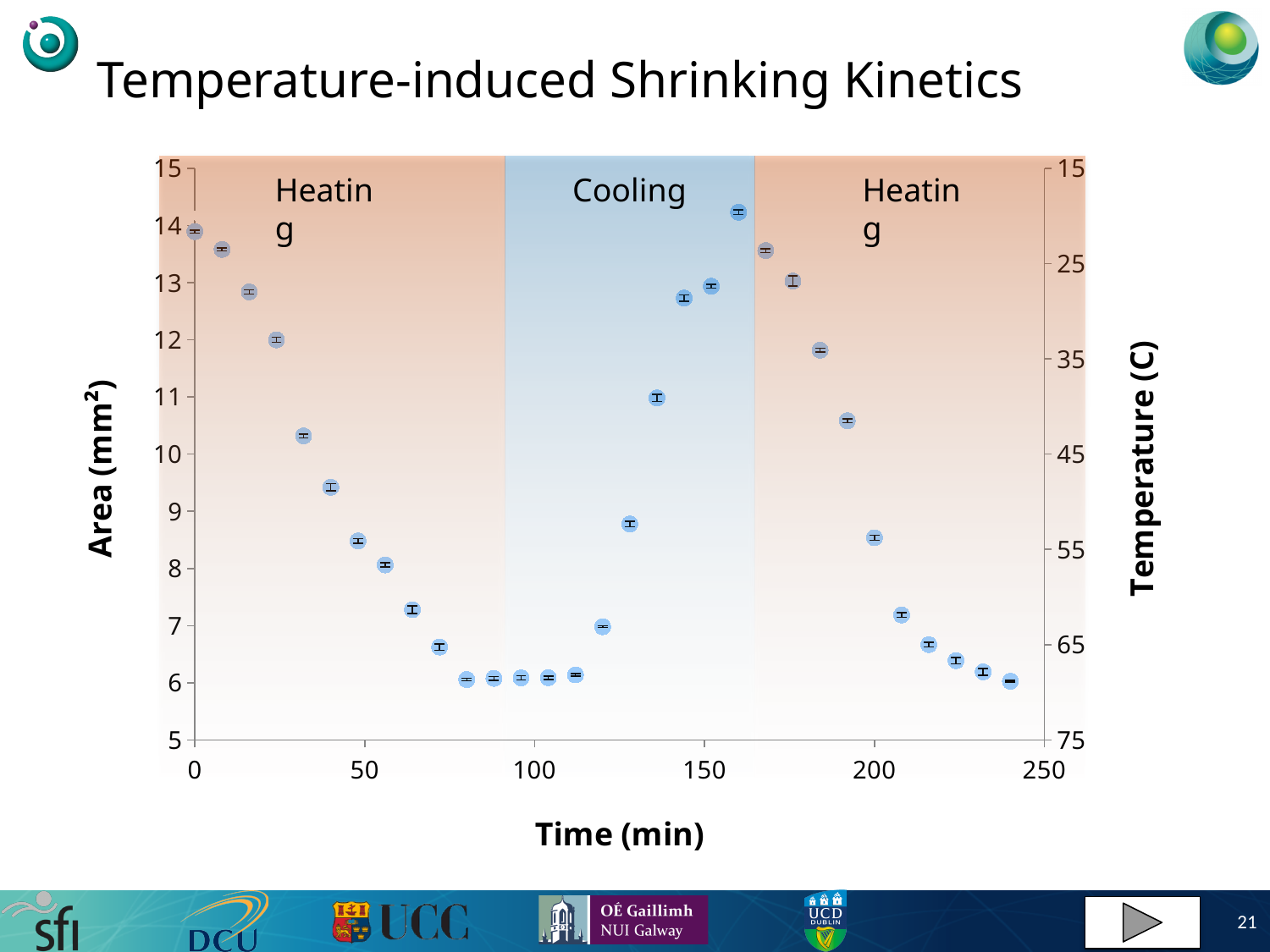
What is the title of the chart? Temperature-induced Shrinking Kinetics Is the area value at around 128 min greater or less than 10 mm²? less Does the area rise or fall with time during the Cooling phase? rise Is the area value at around 240 min greater or less than 7 mm²? less What is the label of the x axis? Time (min) Which is larger, the area at time 0 min or the area at around 48 min? time 0 min What kind of chart is shown on the slide? Scatter plot Which is larger, the area at around 136 min or the area at around 200 min? around 136 min Is the area value at time 0 min greater or less than 13 mm²? greater Does the area rise or fall with time during the first Heating phase (0 to about 90 min)? fall